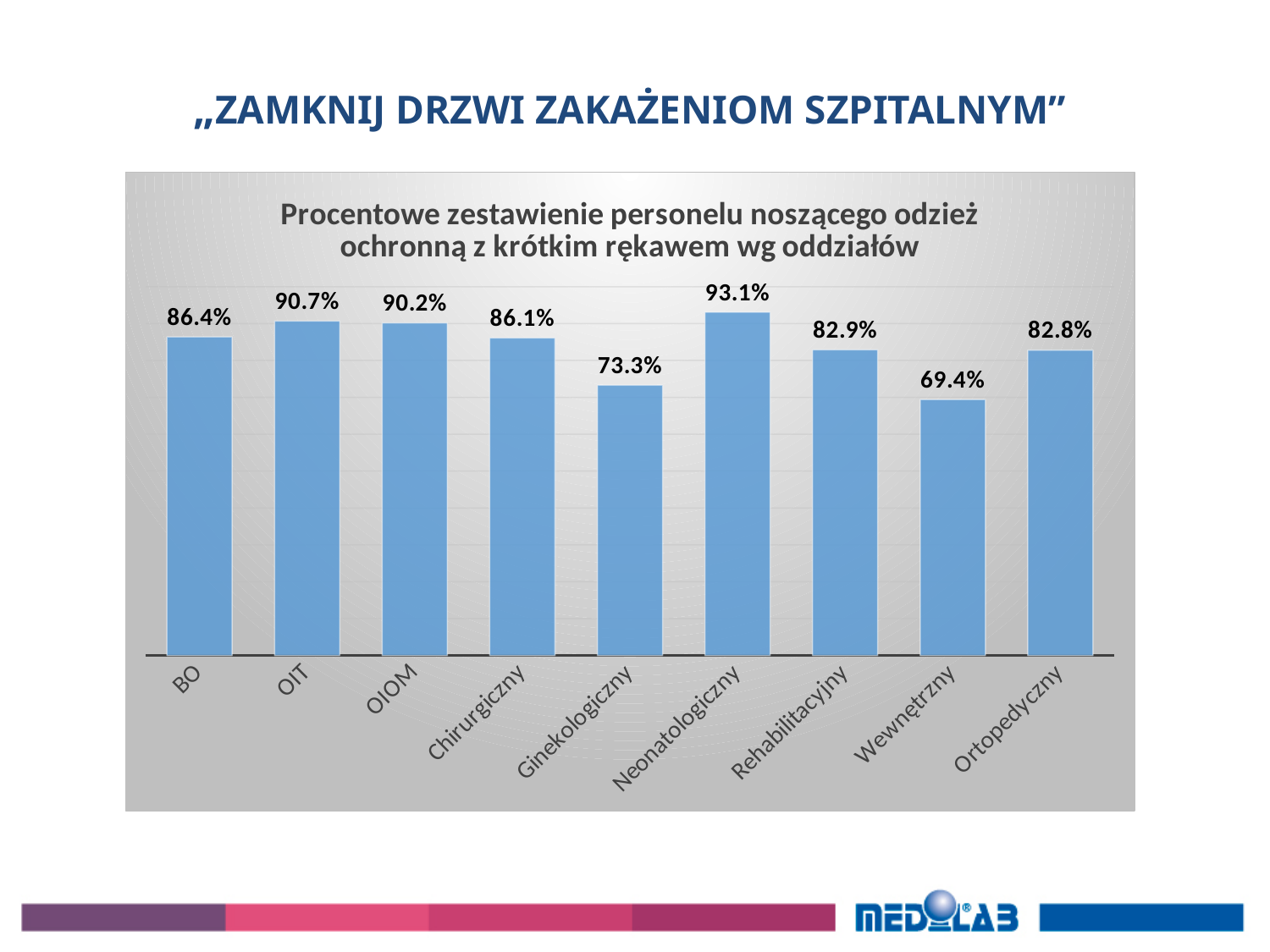
What is the value for Neonatologiczny? 93.1% Which department has the highest value? Neonatologiczny What kind of chart is shown on the slide? Bar chart What is the value for Wewnętrzny? 69.4% Which department has the lowest value? Wewnętrzny How many departments are shown on the chart? 9 What is the value for BO? 86.4% Which is larger, the value for Chirurgiczny or the value for Rehabilitacyjny? Chirurgiczny What is the title of the chart? Procentowe zestawienie personelu noszącego odzież ochronną z krótkim rękawem wg oddziałów What is the value for Ginekologiczny? 73.3% What is the difference between the values for Neonatologiczny and Ginekologiczny? 19.8% What is the difference between the values for OIT and Wewnętrzny? 21.3%